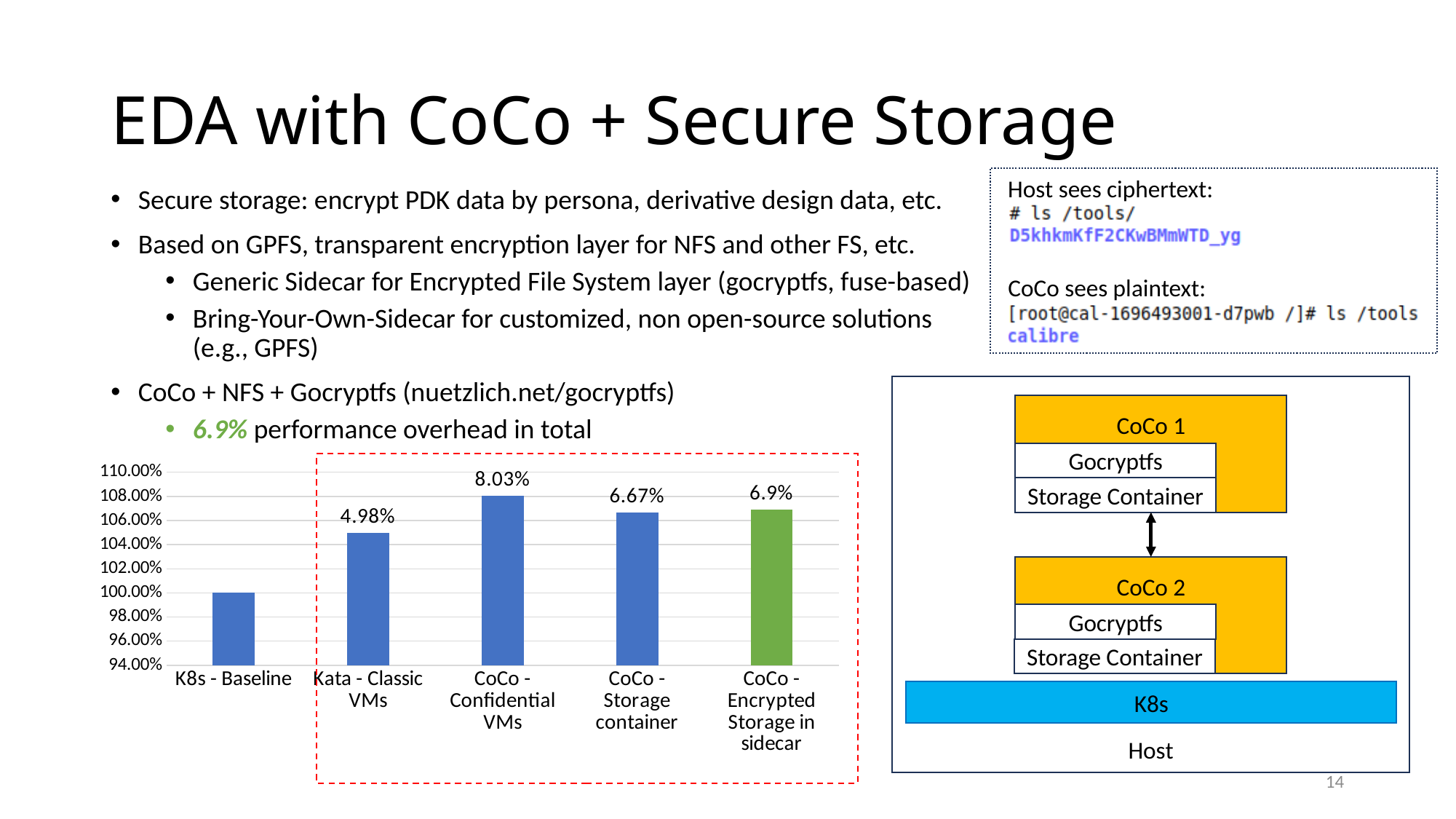
What data label is shown above the bar for CoCo - Encrypted Storage in sidecar? 6.9% What data label is shown above the bar for CoCo - Confidential VMs? 8.03% Which category's bar is coloured green in the chart? CoCo - Encrypted Storage in sidecar Is the bar for Kata - Classic VMs greater or less than 104.00% on the y axis? greater How many categories are shown on the x axis of the chart? 5 What is the difference between the data labels for CoCo - Encrypted Storage in sidecar and Kata - Classic VMs? 1.92% What data label is shown above the bar for CoCo - Storage container? 6.67% What data label is shown above the bar for Kata - Classic VMs? 4.98% What is the difference between the data labels for CoCo - Confidential VMs and CoCo - Storage container? 1.36% Which has the larger data label: CoCo - Storage container or CoCo - Encrypted Storage in sidecar? CoCo - Encrypted Storage in sidecar Which category has the tallest bar in the chart? CoCo - Confidential VMs Which category has the shortest bar in the chart? K8s - Baseline